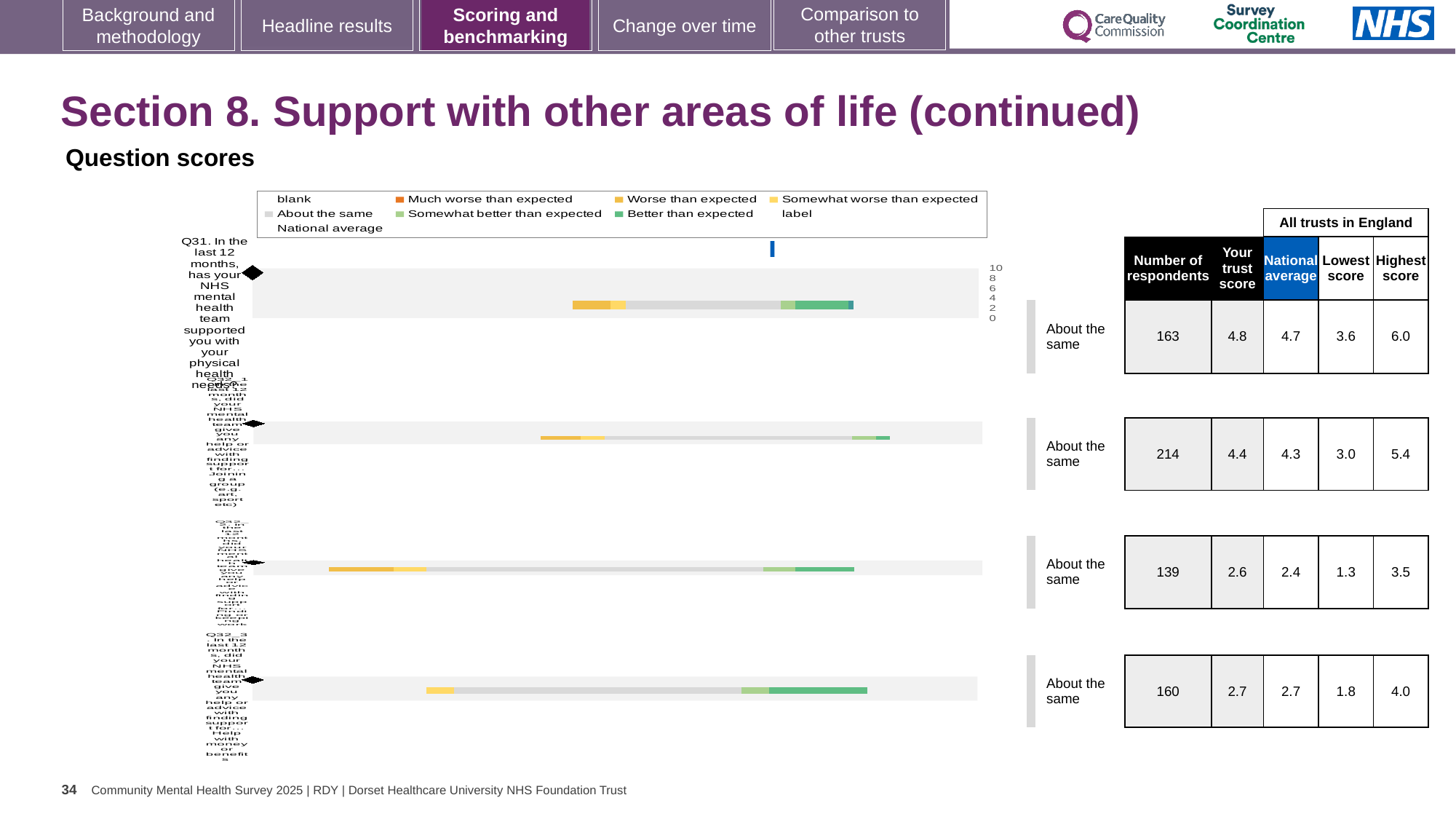
What is 'Your trust score' shown for Q31 (the first bar)? 4.8 What colour does the legend use for 'Better than expected'? green For Q31, what is the difference between the highest score and the lowest score? 2.4 For Q31, which is larger: your trust score or the national average? Your trust score What is the number of respondents shown for Q31 (the first bar)? 163 What benchmark category is shown next to the Q31 bar? About the same How many question bars are plotted in the chart? 4 What kind of chart is used to show the question scores on this slide? bar chart Which bar row has the highest number of respondents? the second row (214) What is the national average shown for Q31 (the first bar)? 4.7 What colour does the legend use for 'Much worse than expected'? orange How many entries does the chart legend list? 9